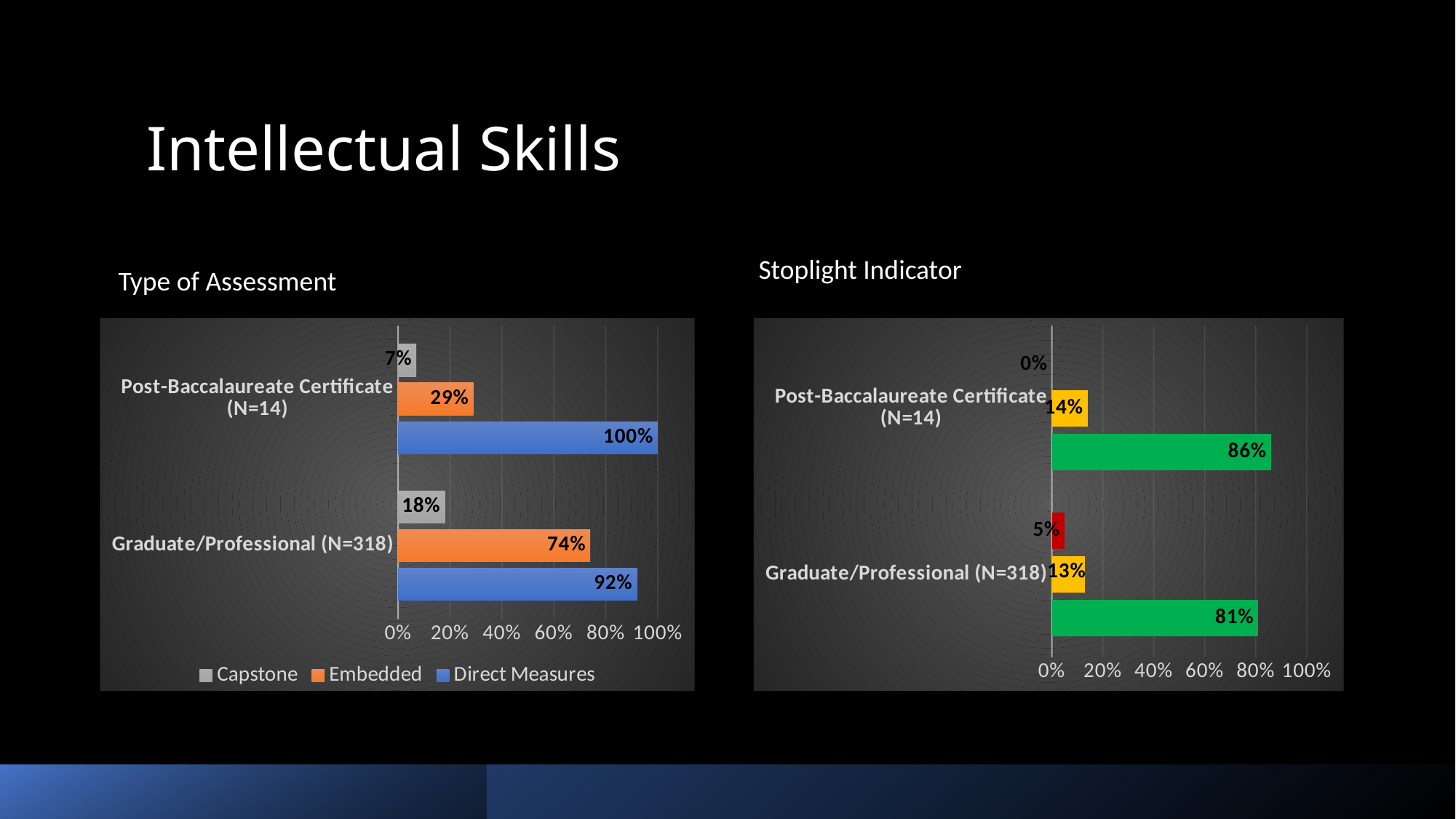
What kind of chart is the Stoplight Indicator chart? Bar chart In the Stoplight Indicator chart, which is larger: the green bar for Post-Baccalaureate Certificate (N=14) or the green bar for Graduate/Professional (N=318)? Post-Baccalaureate Certificate (N=14) How many categories are shown on the y axis of the Stoplight Indicator chart? 2 In the Type of Assessment chart, what is the Embedded value for Graduate/Professional (N=318)? 74% In the Stoplight Indicator chart, what is the value of the red bar for Graduate/Professional (N=318)? 5% In the Stoplight Indicator chart, what is the value of the yellow bar for Post-Baccalaureate Certificate (N=14)? 14% In the Stoplight Indicator chart, what is the value of the green bar for Post-Baccalaureate Certificate (N=14)? 86% In the Type of Assessment chart, what is the Direct Measures value for Post-Baccalaureate Certificate (N=14)? 100% How many series does the legend of the Type of Assessment chart list? 3 In the Type of Assessment chart, what is the difference between the Direct Measures values for Post-Baccalaureate Certificate (N=14) and Graduate/Professional (N=318)? 8% In the Type of Assessment chart, what is the Capstone value for Post-Baccalaureate Certificate (N=14)? 7% In the Type of Assessment chart, which series has the lowest value for Graduate/Professional (N=318)? Capstone